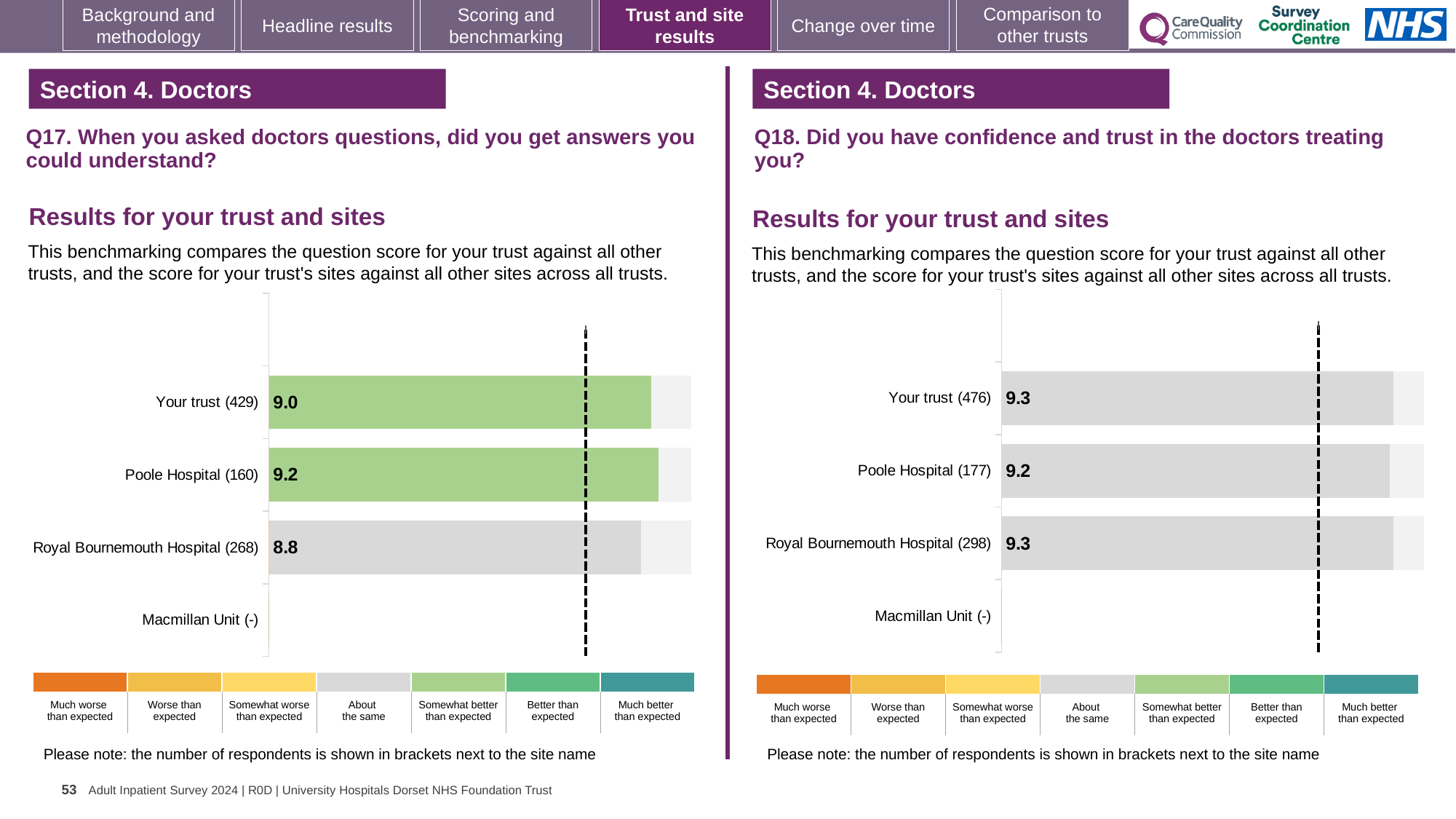
In the Q17 chart on the left, how many respondents are shown in brackets for Poole Hospital? 160 In the Q17 chart on the left, what is the difference between the scores for Poole Hospital and Royal Bournemouth Hospital? 0.4 In the Q18 chart on the right, what is the difference between the scores for Your trust and Poole Hospital? 0.1 In the Q18 chart on the right, what is the score for Your trust? 9.3 How many site categories are listed on the y axis of the Q17 chart on the left? 4 In the Q17 chart on the left, which site has the lowest score among those with a value shown? Royal Bournemouth Hospital In the Q17 chart on the left, which site has the highest score? Poole Hospital In the Q18 chart on the right, which is larger: the score for Royal Bournemouth Hospital or the score for Poole Hospital? Royal Bournemouth Hospital In the Q17 chart on the left, what is the score for Royal Bournemouth Hospital? 8.8 In the Q17 chart on the left, what is the score for Your trust? 9.0 What kind of chart is used for the Q18 results on the right? Bar chart In the Q18 chart on the right, what is the score for Poole Hospital? 9.2